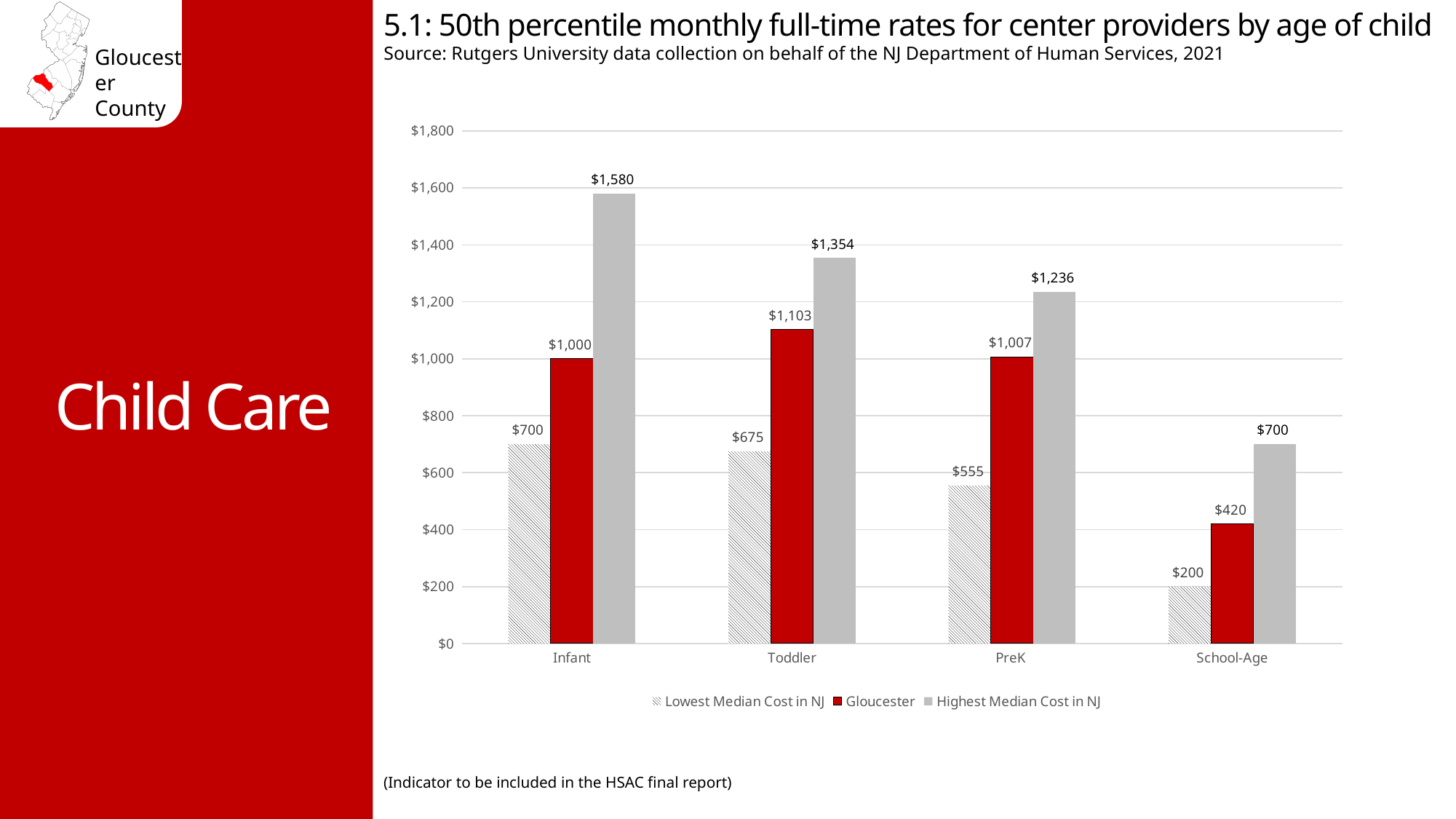
What is the difference between the Highest Median Cost in NJ and the Gloucester value for Infant? $580 Which series is shown in red? Gloucester Do the Highest Median Cost in NJ values rise or fall from Infant to School-Age? Fall How many age categories are shown on the x axis? 4 What is the Highest Median Cost in NJ for Toddler? $1,354 What kind of chart is shown? Bar chart How many series does the legend list? 3 Which is larger for PreK: the Gloucester value or the Lowest Median Cost in NJ? Gloucester Which age category has the highest Gloucester value? Toddler Which age category has the lowest Highest Median Cost in NJ? School-Age What is the Gloucester value for Infant? $1,000 What is the Lowest Median Cost in NJ for School-Age? $200